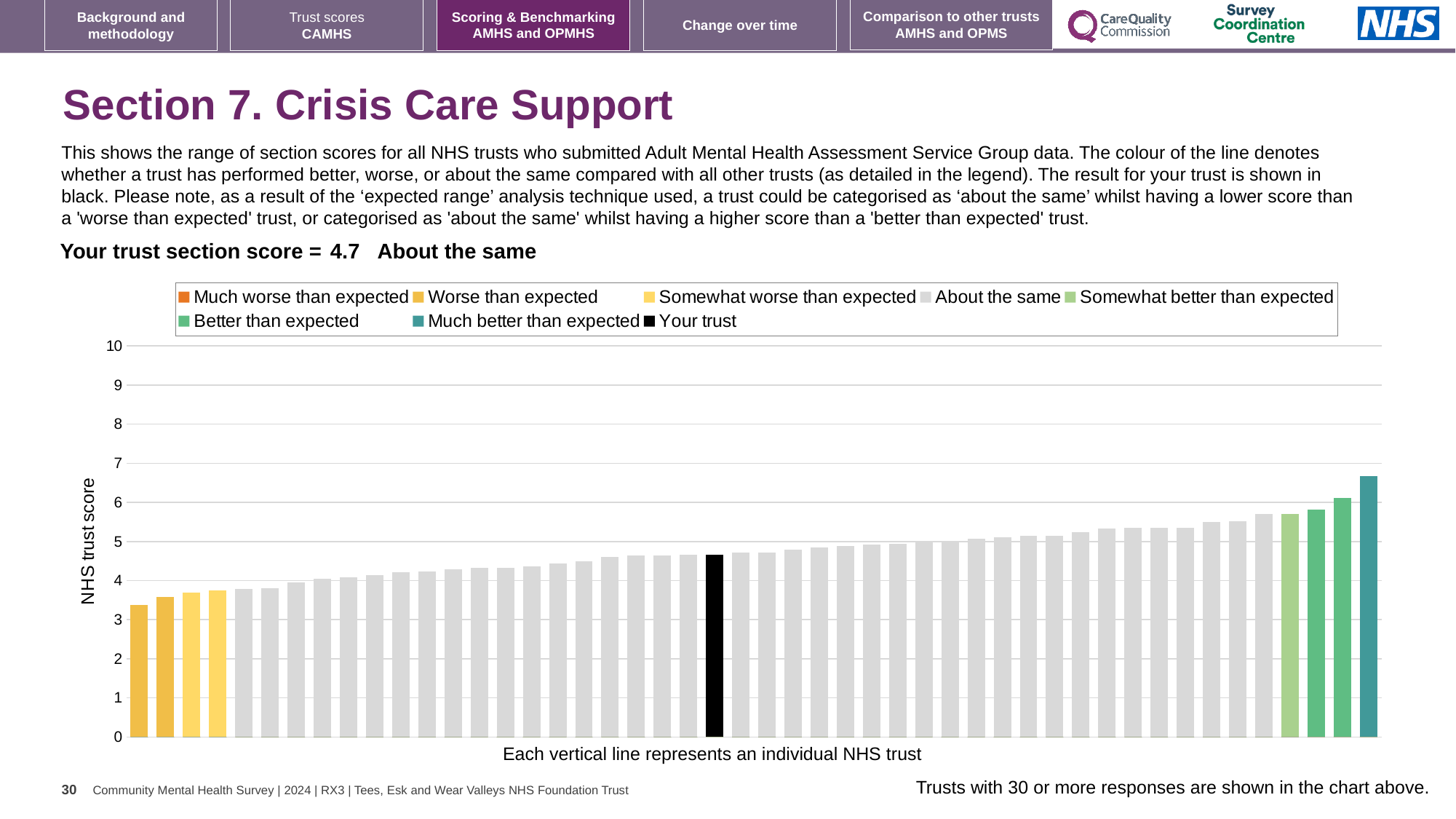
Which legend category does the highest bar (the rightmost, teal bar) belong to? Much better than expected Which benchmarking category is your trust placed in for this section? About the same Is the value for your trust (the black bar) greater or less than 4? greater Do the bar values rise or fall from left to right across the chart? rise How many entries does the chart legend list? 8 Is the value of the lowest bar in the chart greater or less than 4? less Is the value of the highest bar in the chart greater or less than 6? greater What kind of chart is shown on the slide? bar chart Which legend category does the lowest bar (the leftmost bar) belong to? Worse than expected What is the label on the vertical axis of the chart? NHS trust score What is the section score for your trust shown on the slide? 4.7